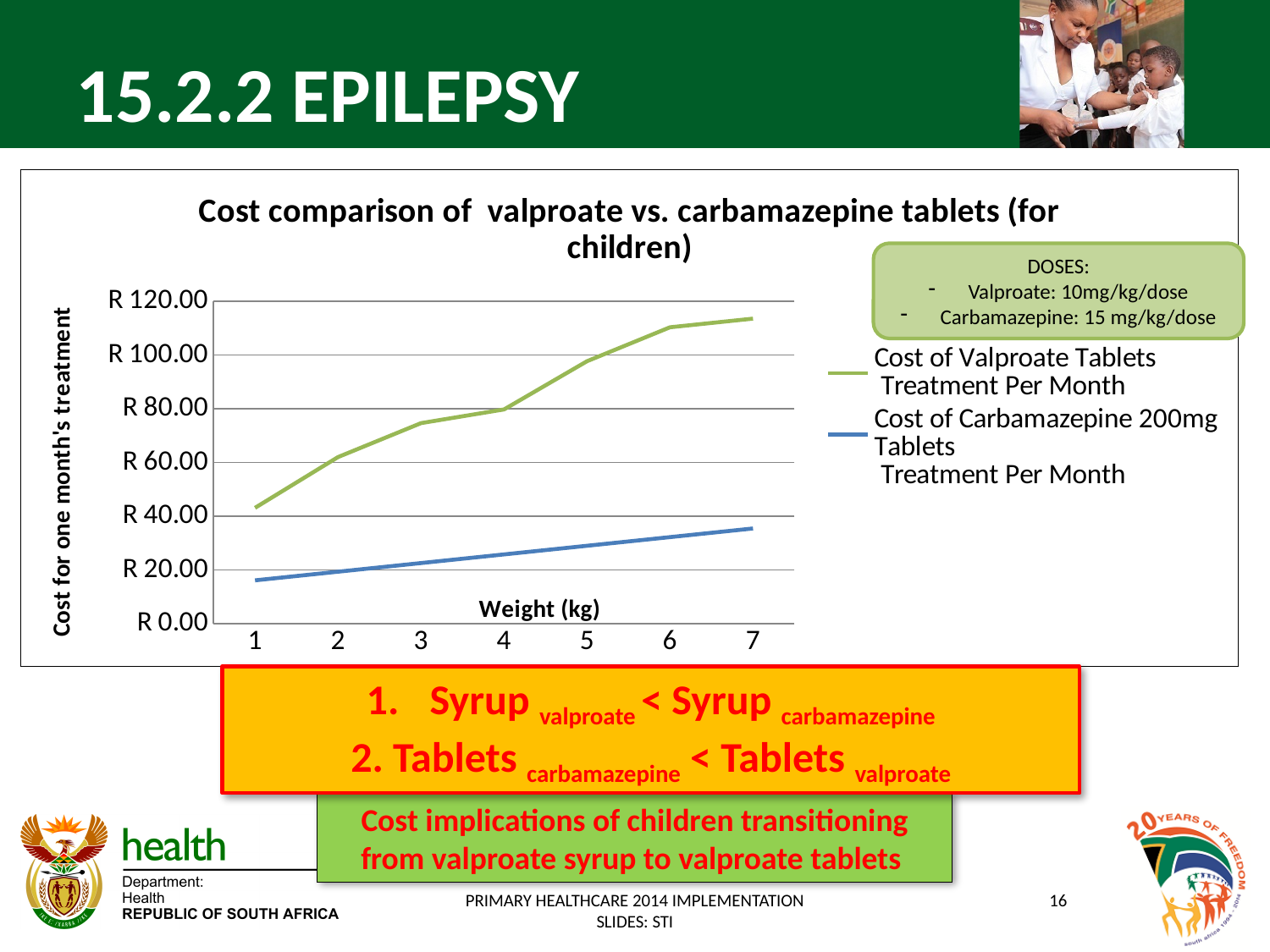
How many weight categories are shown on the x axis of the chart? 7 Is the cost of valproate tablets treatment per month at 1 kg greater or less than R 60.00? less What kind of chart is shown on the slide? line chart How many series does the chart's legend list? 2 Does the cost of valproate tablets treatment per month rise or fall as weight increases along the x axis? rise Is the cost of valproate tablets treatment per month at 7 kg greater or less than R 100.00? greater Is the cost of carbamazepine 200mg tablets treatment per month at 7 kg greater or less than R 40.00? less What is the title of the chart? Cost comparison of valproate vs. carbamazepine tablets (for children) What is the label of the chart's y axis? Cost for one month's treatment At a weight of 7 kg, which series has the higher monthly treatment cost: valproate tablets or carbamazepine 200mg tablets? Cost of Valproate Tablets Treatment Per Month Does the cost of carbamazepine 200mg tablets treatment per month rise or fall as weight increases along the x axis? rise